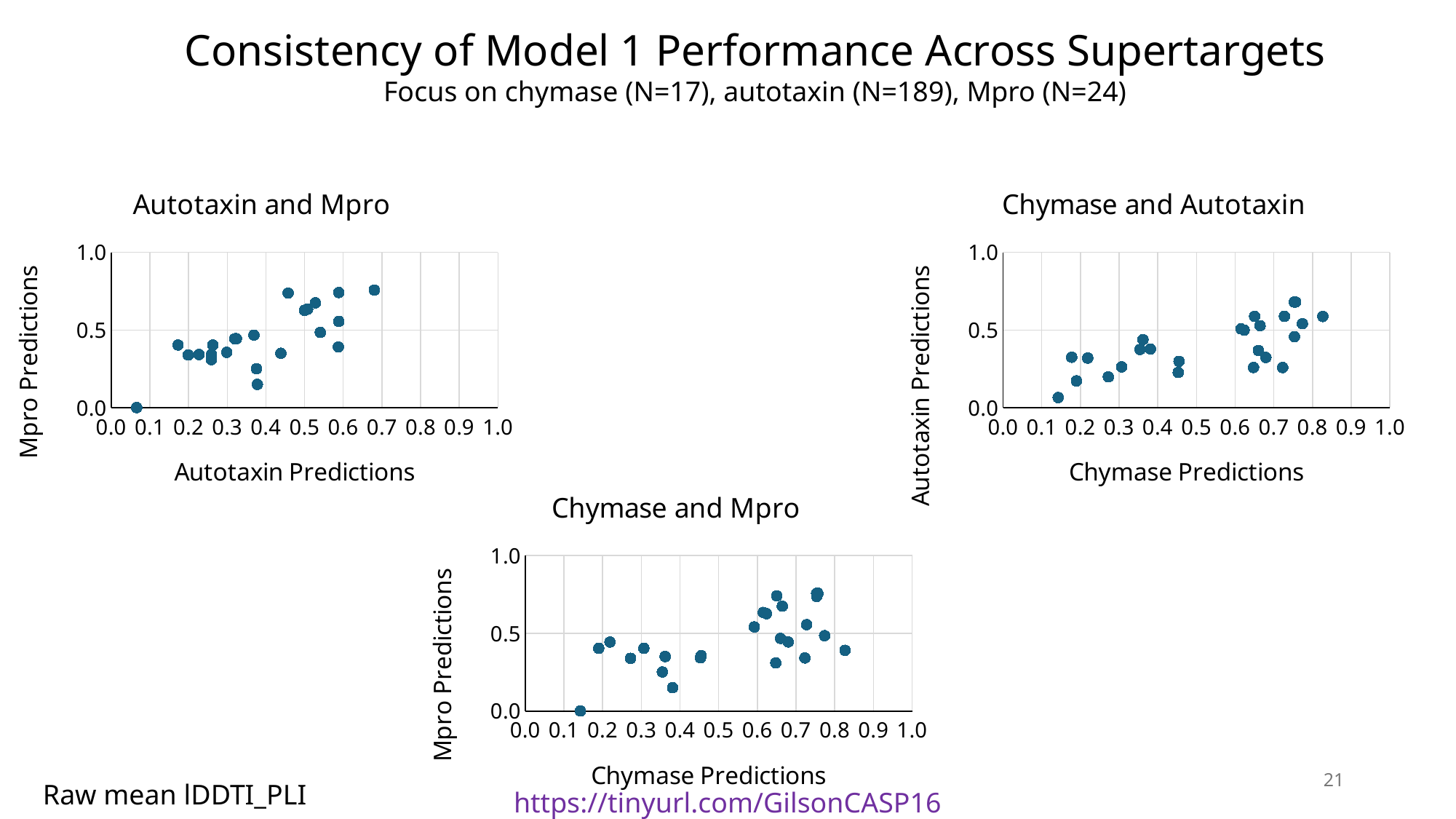
How many charts are shown on the slide? 3 In the "Chymase and Autotaxin" chart, is the largest Chymase Predictions value greater or less than 0.5? greater In the "Autotaxin and Mpro" chart, do the Mpro Predictions generally rise or fall as Autotaxin Predictions increase? Rise What is the maximum value shown on the y axis of the "Chymase and Mpro" chart? 1.0 In the "Chymase and Autotaxin" chart, is the lowest Autotaxin Predictions value greater or less than 0.5? less In the "Chymase and Mpro" chart, is the highest Mpro Predictions value greater or less than 0.5? greater In the "Autotaxin and Mpro" chart, what is the label of the y axis? Mpro Predictions In the "Chymase and Autotaxin" chart, what is the label of the x axis? Chymase Predictions In the "Chymase and Mpro" chart, do the Mpro Predictions generally rise or fall as Chymase Predictions increase? Rise In the "Chymase and Autotaxin" chart, do the Autotaxin Predictions generally rise or fall as Chymase Predictions increase? Rise What kind of chart is the "Autotaxin and Mpro" chart? Scatter chart